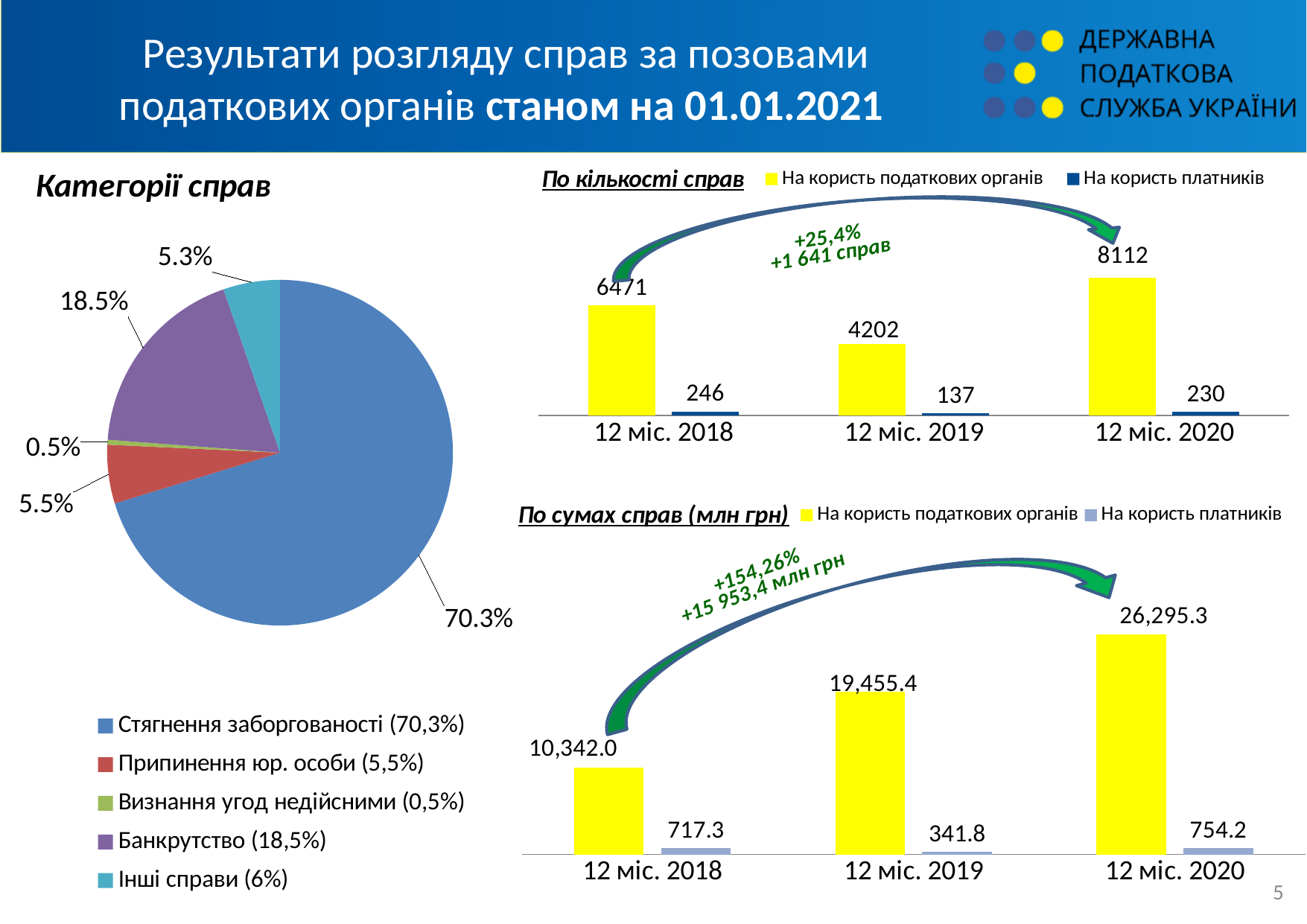
In the chart 'По кількості справ', which is larger for 'На користь податкових органів': 12 міс. 2018 or 12 міс. 2019? 12 міс. 2018 In the chart 'По сумах справ (млн грн)', what is the value for 'На користь платників' in 12 міс. 2018? 717.3 What type of chart is 'По кількості справ'? Bar chart In the chart 'По сумах справ (млн грн)', which period has the lowest value for 'На користь платників'? 12 міс. 2019 In the chart 'По кількості справ', what is the value for 'На користь податкових органів' in 12 міс. 2020? 8112 In the chart 'По сумах справ (млн грн)', which period has the highest value for 'На користь податкових органів'? 12 міс. 2020 In the chart 'По кількості справ', what is the value for 'На користь платників' in 12 міс. 2019? 137 In the pie chart 'Категорії справ', which category has the largest slice? Стягнення заборгованості In the chart 'По кількості справ', what is the difference between the 'На користь податкових органів' values for 12 міс. 2020 and 12 міс. 2018? 1641 How many series does the legend of the chart 'По сумах справ (млн грн)' list? 2 In the pie chart 'Категорії справ', what share does 'Банкрутство' have? 18.5% In the chart 'По сумах справ (млн грн)', what is the difference between the 'На користь податкових органів' values for 12 міс. 2020 and 12 міс. 2019? 6,839.9